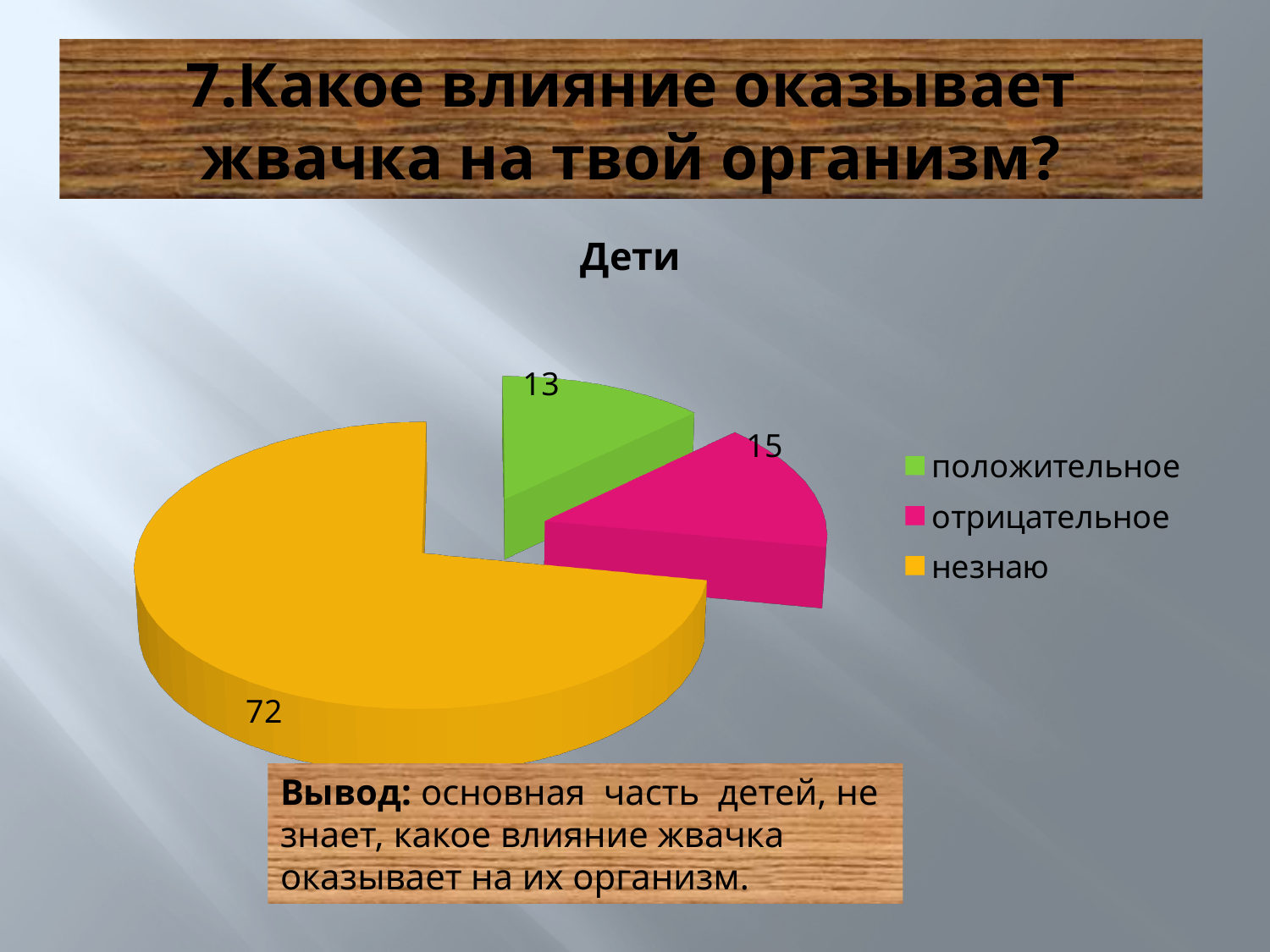
What is the title of the chart? Дети How many slices does the pie chart have? 3 Which is larger, the value for "отрицательное" or the value for "положительное"? отрицательное Which category has the largest slice? незнаю What share of the pie does "незнаю" represent? 72% What is the difference between the values for "незнаю" and "отрицательное"? 57 What is the value for "незнаю"? 72 What is the value for "отрицательное"? 15 What is the value for "положительное"? 13 What colour is the slice for "отрицательное"? pink Which category has the smallest slice? положительное What type of chart is shown on the slide? pie chart